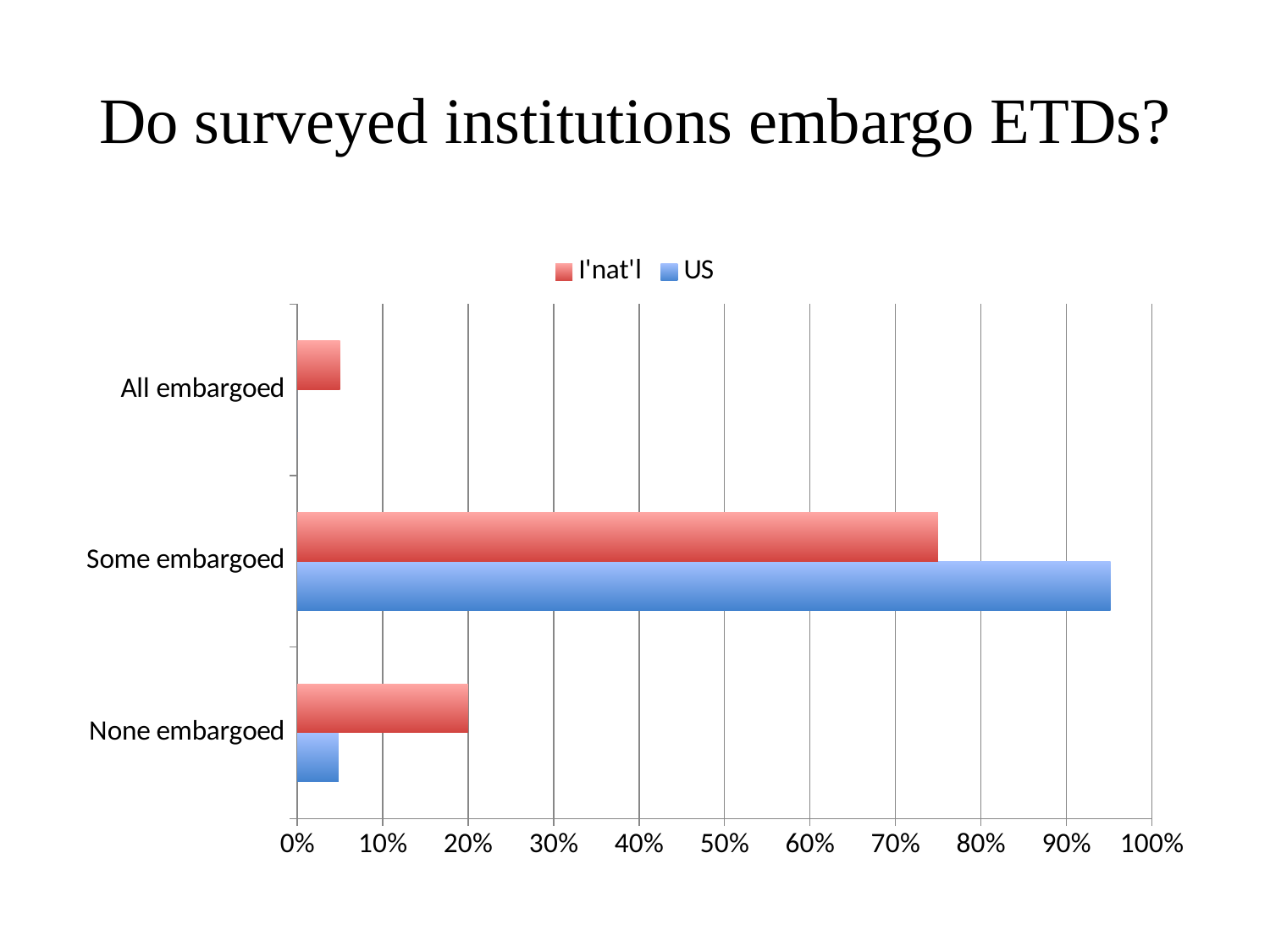
For None embargoed, which series has the larger value, I'nat'l or US? I'nat'l Which category has the highest value for the I'nat'l series? Some embargoed Is the I'nat'l value for All embargoed greater or less than 10%? less Which category has the highest value for the US series? Some embargoed How many categories are shown on the vertical axis? 3 Is the US value for Some embargoed greater or less than 90%? greater Is the US value for None embargoed greater or less than 10%? less Which colour represents the US series in the chart? blue What kind of chart is shown on the slide? bar chart How many series does the legend list? 2 For Some embargoed, which series has the larger value, I'nat'l or US? US